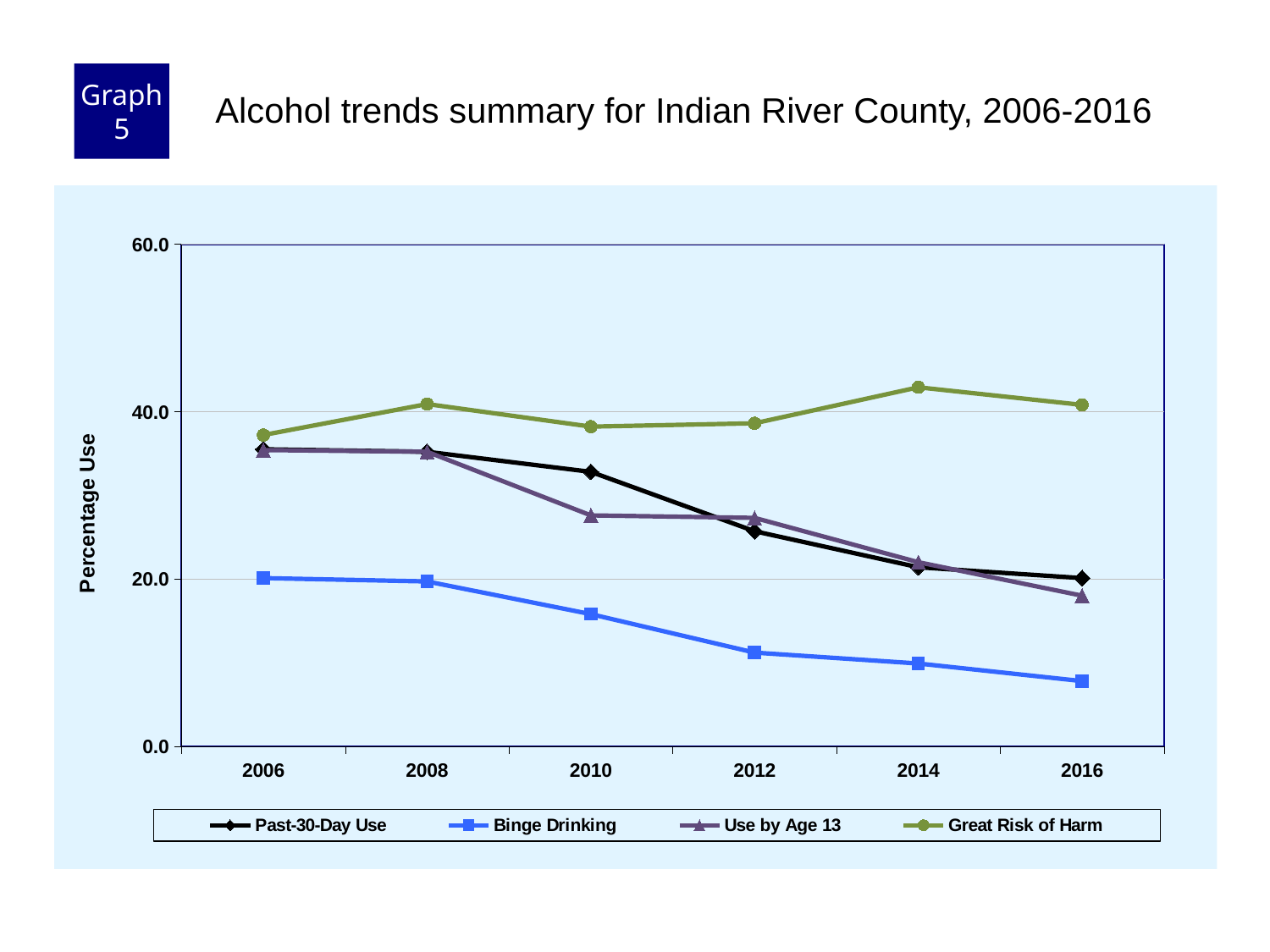
In 2010, which is larger: Great Risk of Harm or Binge Drinking? Great Risk of Harm What is the title of the y axis? Percentage Use How many years are plotted along the x axis? 6 Which series has the highest value in 2016? Great Risk of Harm Is the value for Past-30-Day Use in 2010 greater or less than 40.0? less Is the value for Great Risk of Harm in 2014 greater or less than 40.0? greater Which series has the lowest value in 2012? Binge Drinking Does the Binge Drinking line rise or fall from 2006 to 2016? fall Is the value for Binge Drinking in 2016 greater or less than 20.0? less What kind of chart is shown on the slide? line chart How many series does the legend list? 4 Which series is drawn with square markers? Binge Drinking